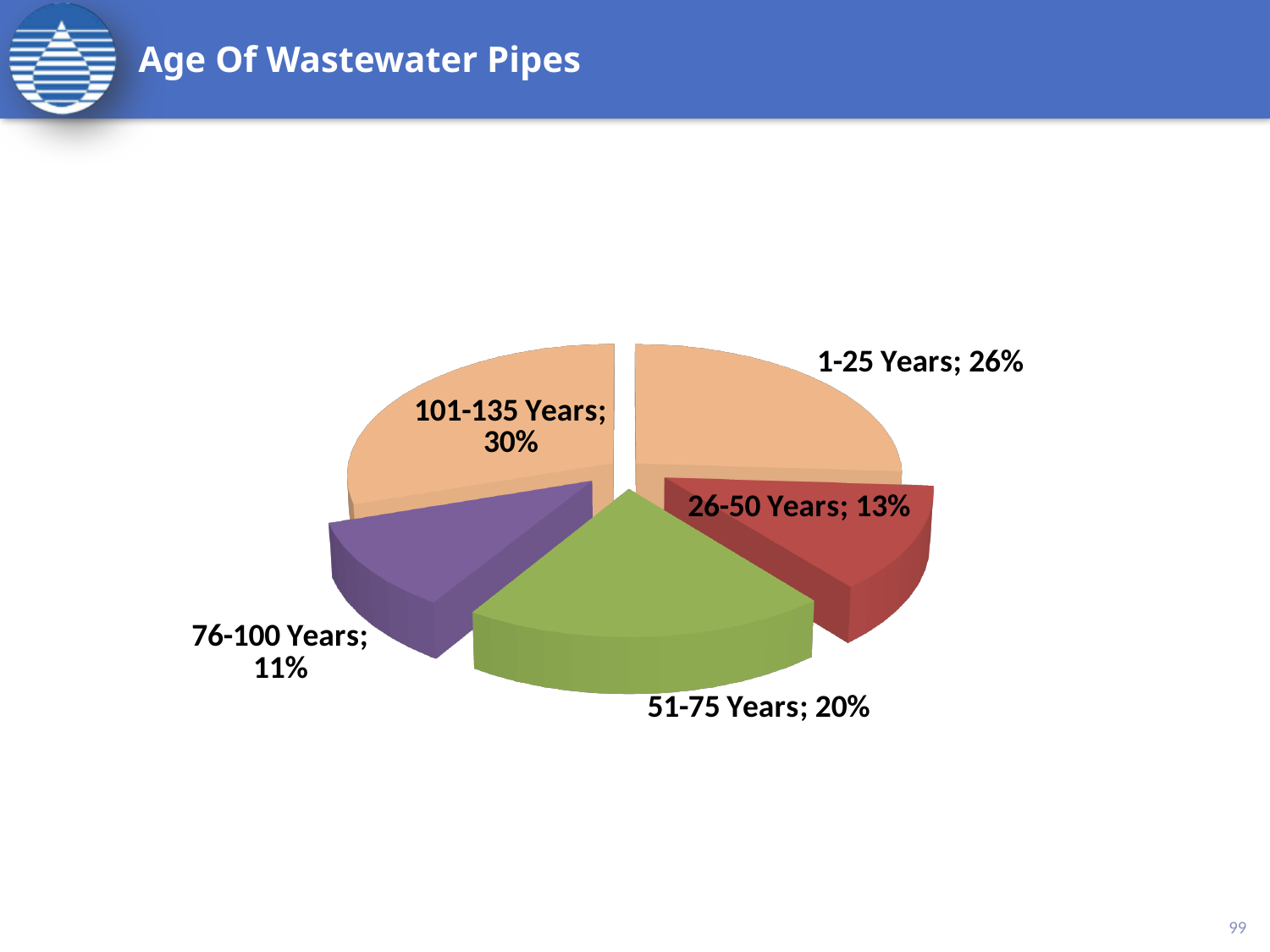
What is the title of the slide containing the chart? Age Of Wastewater Pipes What percentage of wastewater pipes are 1-25 years old? 26% What percentage of wastewater pipes are 101-135 years old? 30% What percentage of wastewater pipes are 76-100 years old? 11% How many age categories are shown in the pie chart? 5 What percentage of wastewater pipes are 26-50 years old? 13% What type of chart is shown on the slide? Pie chart Which is larger, the share for 1-25 Years or the share for 51-75 Years? 1-25 Years What percentage of wastewater pipes are 51-75 years old? 20% What is the difference in percentage points between the 101-135 Years slice and the 26-50 Years slice? 17 Which age group has the largest share of wastewater pipes? 101-135 Years Which age group has the smallest share of wastewater pipes? 76-100 Years